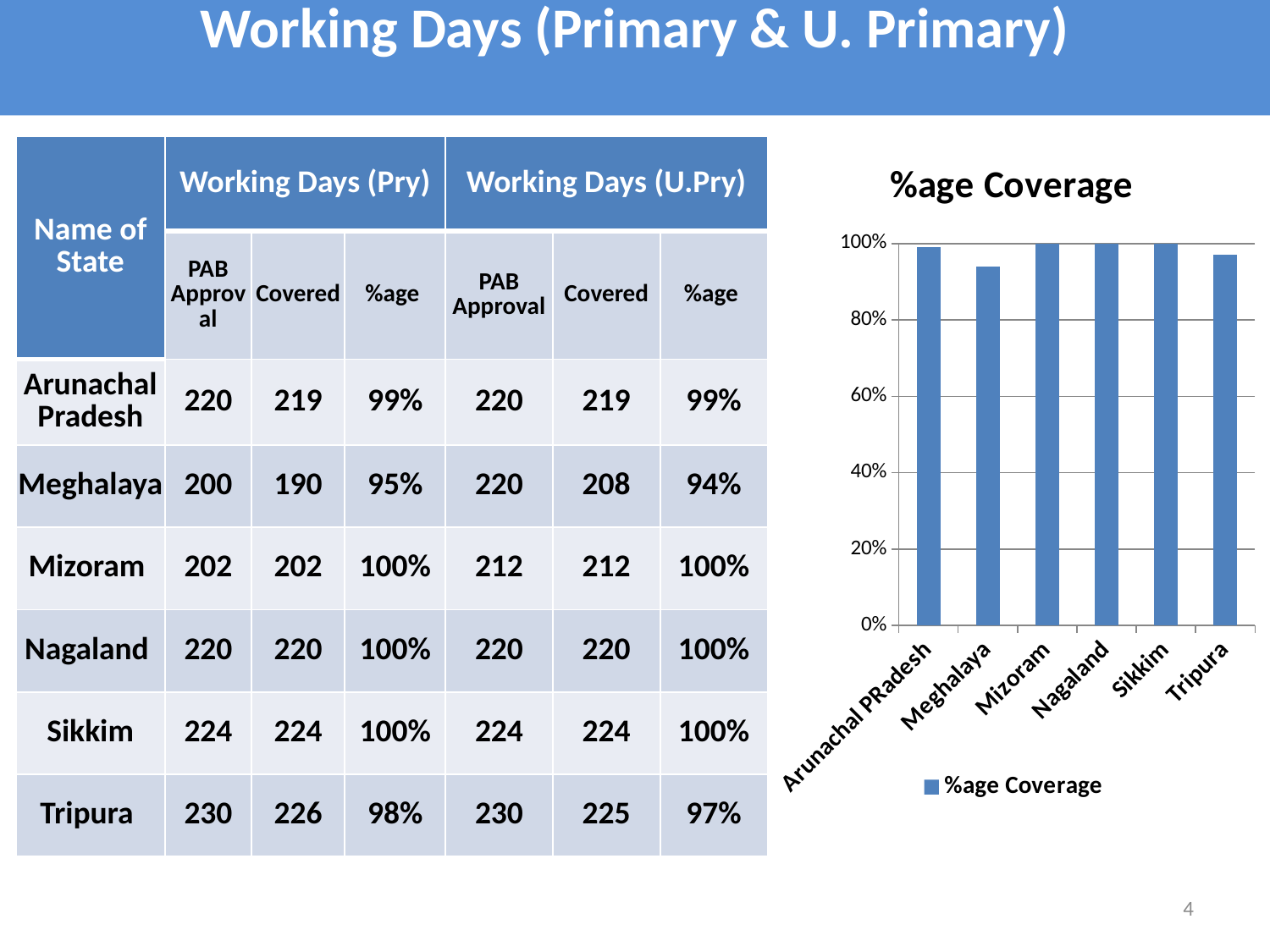
Which state has the lowest bar on the chart? Meghalaya What is the value for Sikkim on the chart? 100% What is the value for Mizoram on the chart? 100% What is the name of the series shown in the chart legend? %age Coverage Is the value for Meghalaya greater or less than 80%? greater How many states are plotted on the chart? 6 What kind of chart is shown on the slide? bar chart How many series does the chart legend list? 1 What is the title of the chart? %age Coverage Is the value for Tripura greater or less than 60%? greater What is the value for Nagaland on the chart? 100% Which is larger on the chart, the value for Arunachal Pradesh or the value for Meghalaya? Arunachal Pradesh